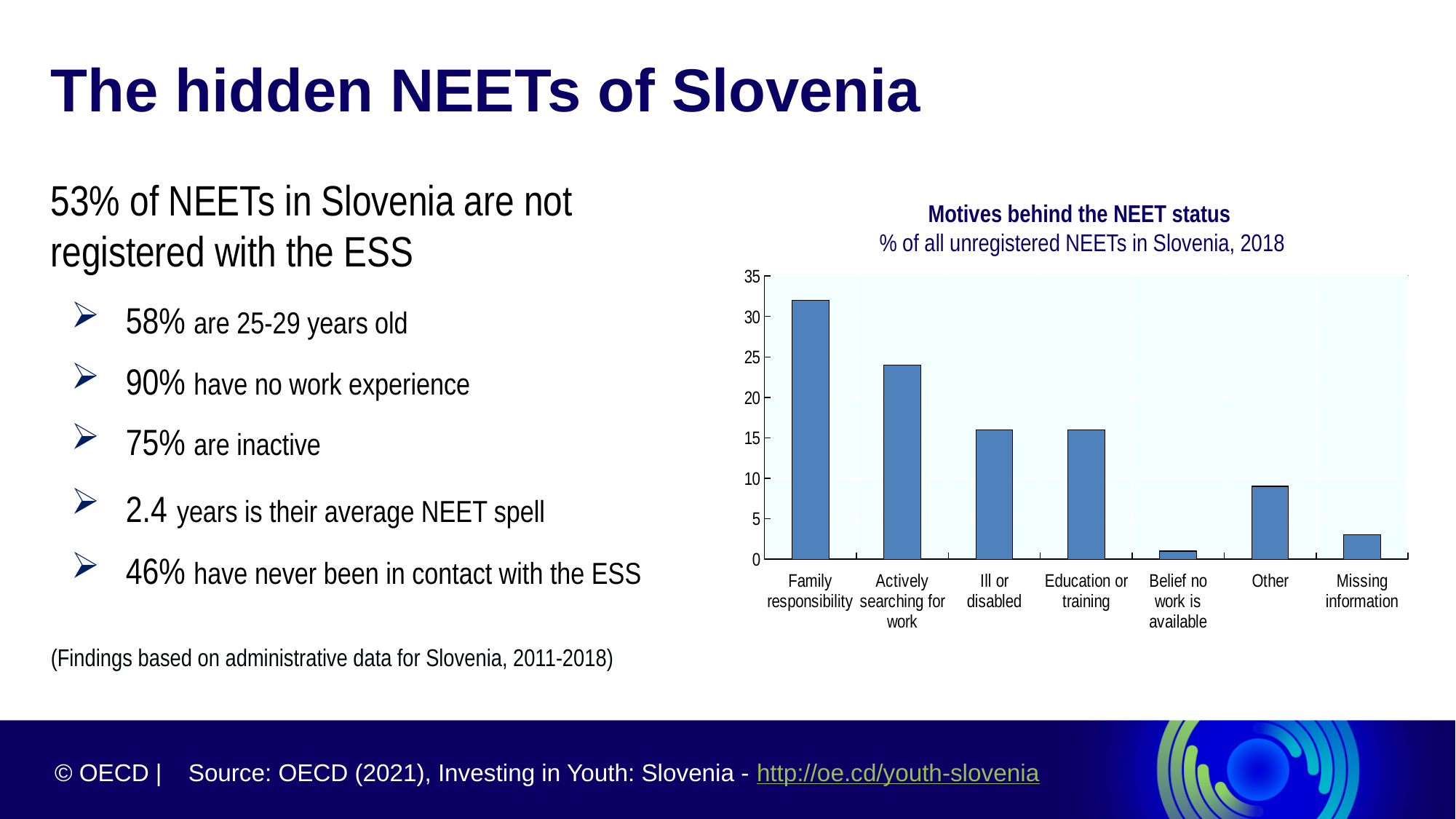
Is the value for Ill or disabled greater or less than 15? greater Which category has the lowest value in the chart? Belief no work is available How many categories are shown on the x axis of the chart? 7 Is the value for Missing information greater or less than 5? less Is the value for Other greater or less than 10? less Which is larger, the value for Actively searching for work or the value for Other? Actively searching for work What kind of chart is shown on the slide? bar chart What is the title of the chart? Motives behind the NEET status Which category has the highest value in the chart? Family responsibility What does the subtitle of the chart say the values represent? % of all unregistered NEETs in Slovenia, 2018